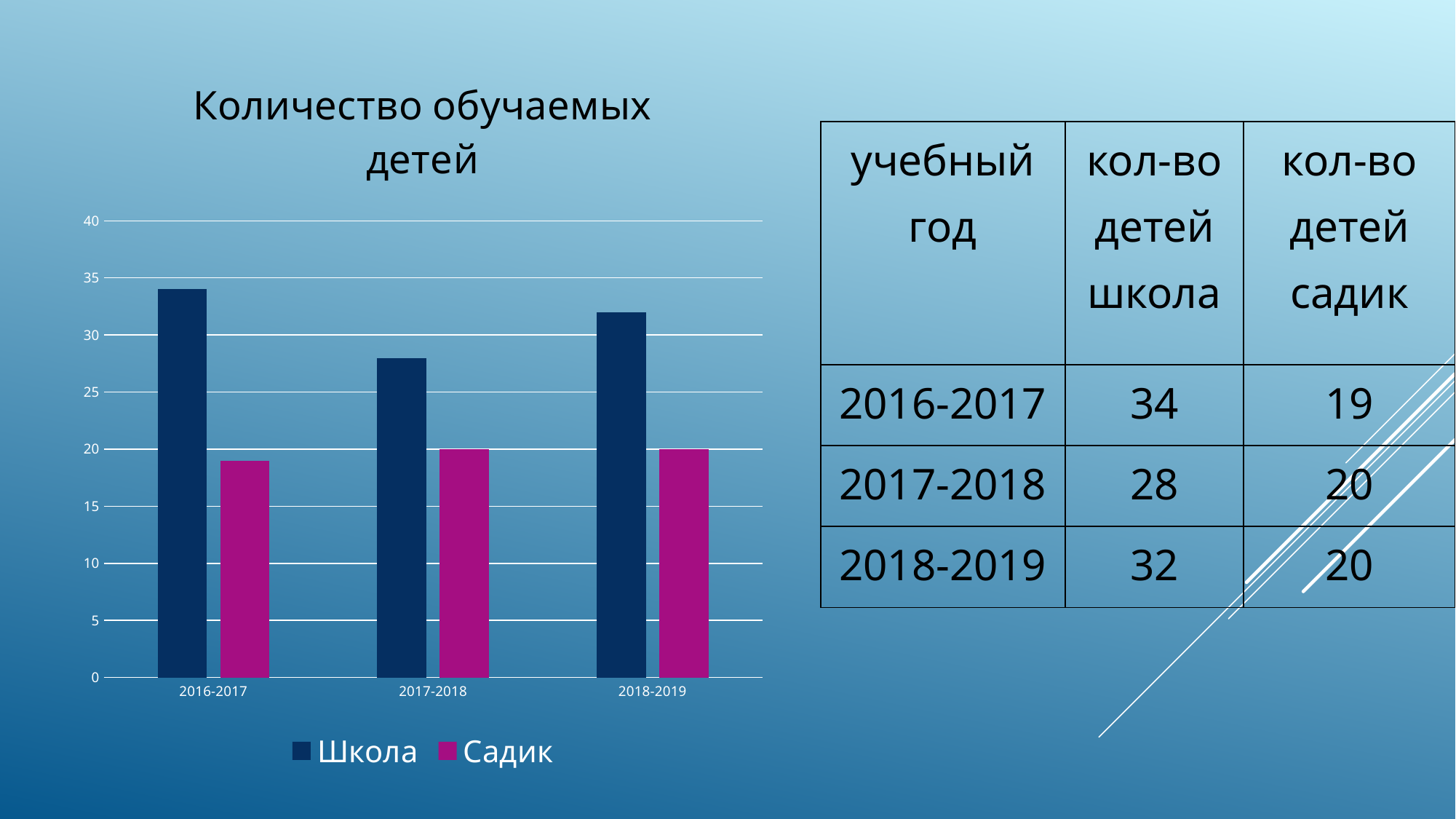
What is the value for Школа in 2017-2018? 28 Which academic year has the highest value for Школа? 2016-2017 Which academic year has the lowest value for Садик? 2016-2017 How many series does the chart legend list? 2 What is the difference between Школа and Садик in 2018-2019? 12 What is the value for Садик in 2017-2018? 20 How many academic years are shown on the x axis of the chart? 3 Is the value for Школа in 2017-2018 greater or less than 30? less What kind of chart is shown on the slide? bar chart Which is larger in 2016-2017, Школа or Садик? Школа What is the value for Школа in 2016-2017? 34 What is the title of the chart? Количество обучаемых детей